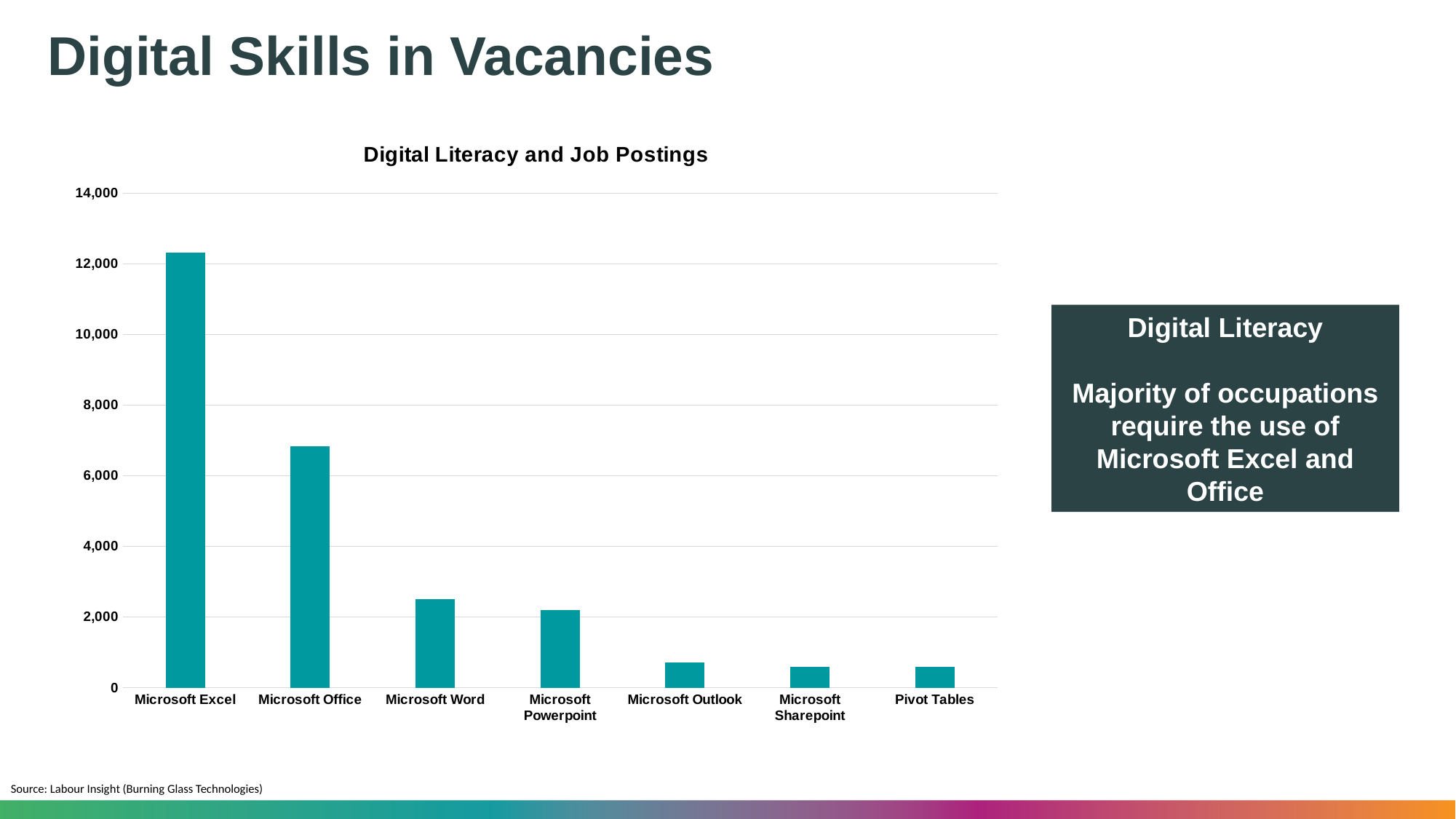
Do the values generally rise or fall from left to right across the categories? fall Which category has the highest value? Microsoft Excel Is the value for Microsoft Outlook greater or less than 2,000? less What is the title of the chart? Digital Literacy and Job Postings Is the value for Microsoft Office greater or less than 8,000? less Is the value for Microsoft Word greater or less than 2,000? greater What kind of chart is shown on the slide? bar chart How many categories are plotted on the chart? 7 Which is larger, the value for Microsoft Powerpoint or the value for Microsoft Outlook? Microsoft Powerpoint Which is larger, the value for Microsoft Office or the value for Microsoft Word? Microsoft Office What is the source cited for the chart? Labour Insight (Burning Glass Technologies)